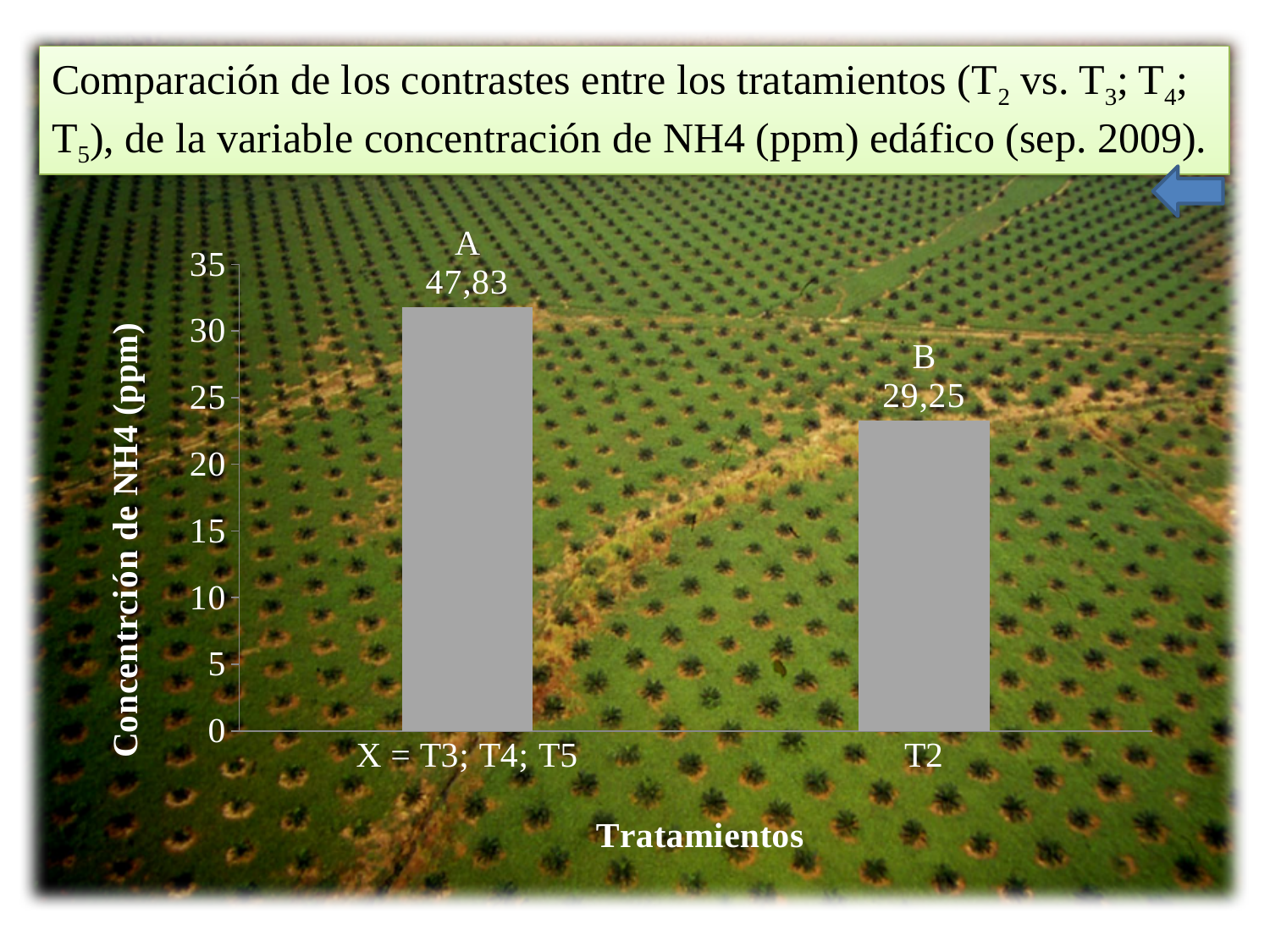
How many treatment categories are plotted on the chart? 2 Which treatment category has the highest NH4 concentration? X = T3; T4; T5 What is the difference between the values for X = T3; T4; T5 and T2? 18,58 What is the NH4 concentration value shown for X = T3; T4; T5? 47,83 What kind of chart is shown on the slide? Bar chart What is the label of the y axis? Concentrción de NH4 (ppm) What is the NH4 concentration value shown for T2? 29,25 Which treatment category has the lowest NH4 concentration? T2 Which is larger, the value for X = T3; T4; T5 or the value for T2? X = T3; T4; T5 What letter is printed above the bar for T2? B